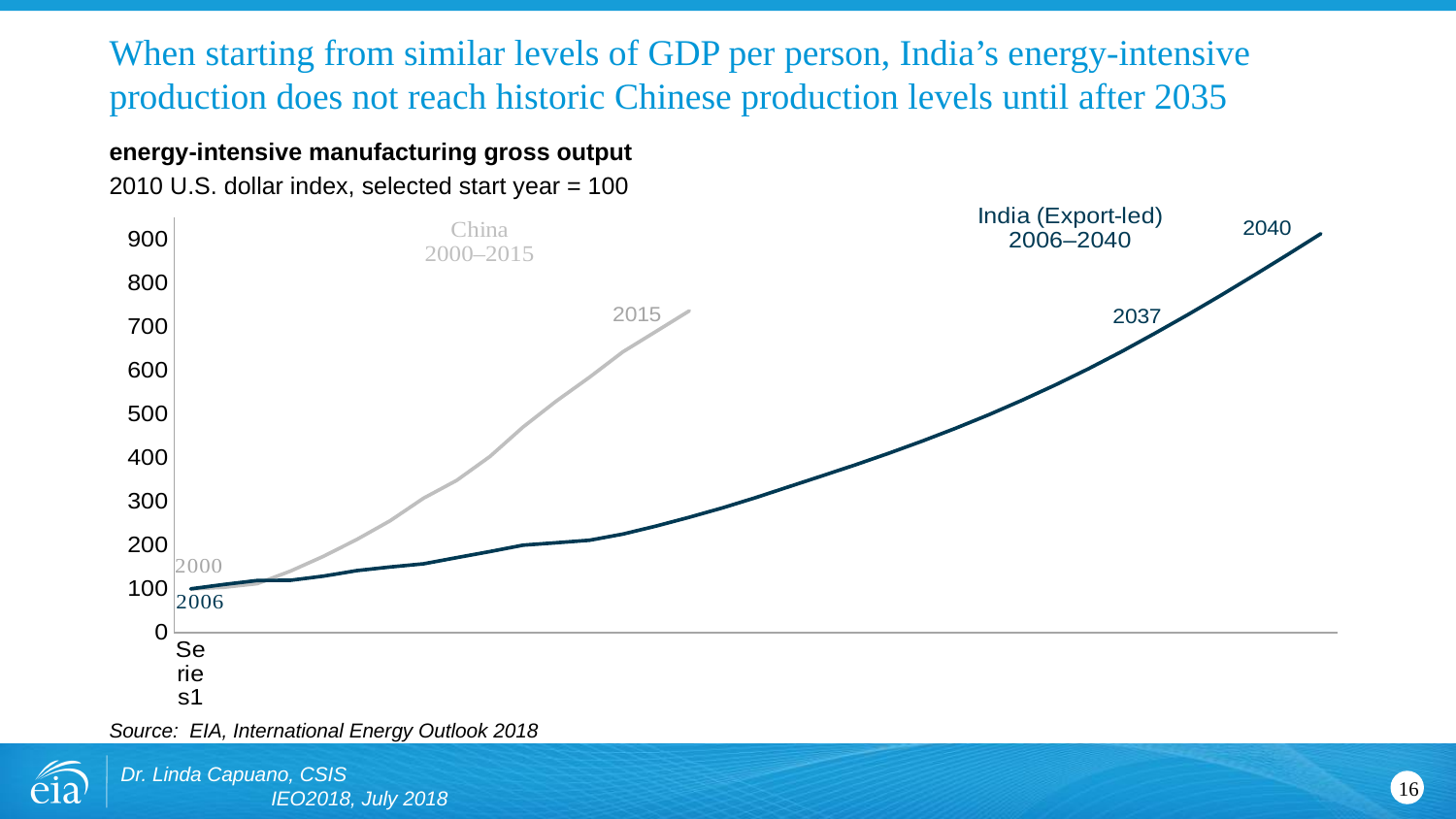
Which year range does the China series cover? 2000–2015 What is the title of the chart? energy-intensive manufacturing gross output Is the value for India (Export-led) in 2040 greater or less than 800? greater Is the value for China in 2015 greater or less than 700? greater What kind of chart is shown on the slide? line chart Which is larger: the India (Export-led) value in 2040 or the China value in 2015? India (Export-led) in 2040 Which series reaches the highest value on the chart? India (Export-led) Do the values of the India (Export-led) series rise or fall from 2006 to 2040? rise Is the value for India (Export-led) in 2037 greater or less than 600? greater What index value does each series start at in its selected start year? 100 What is the highest value shown on the vertical axis? 900 How many series (lines) are plotted on the chart? 2